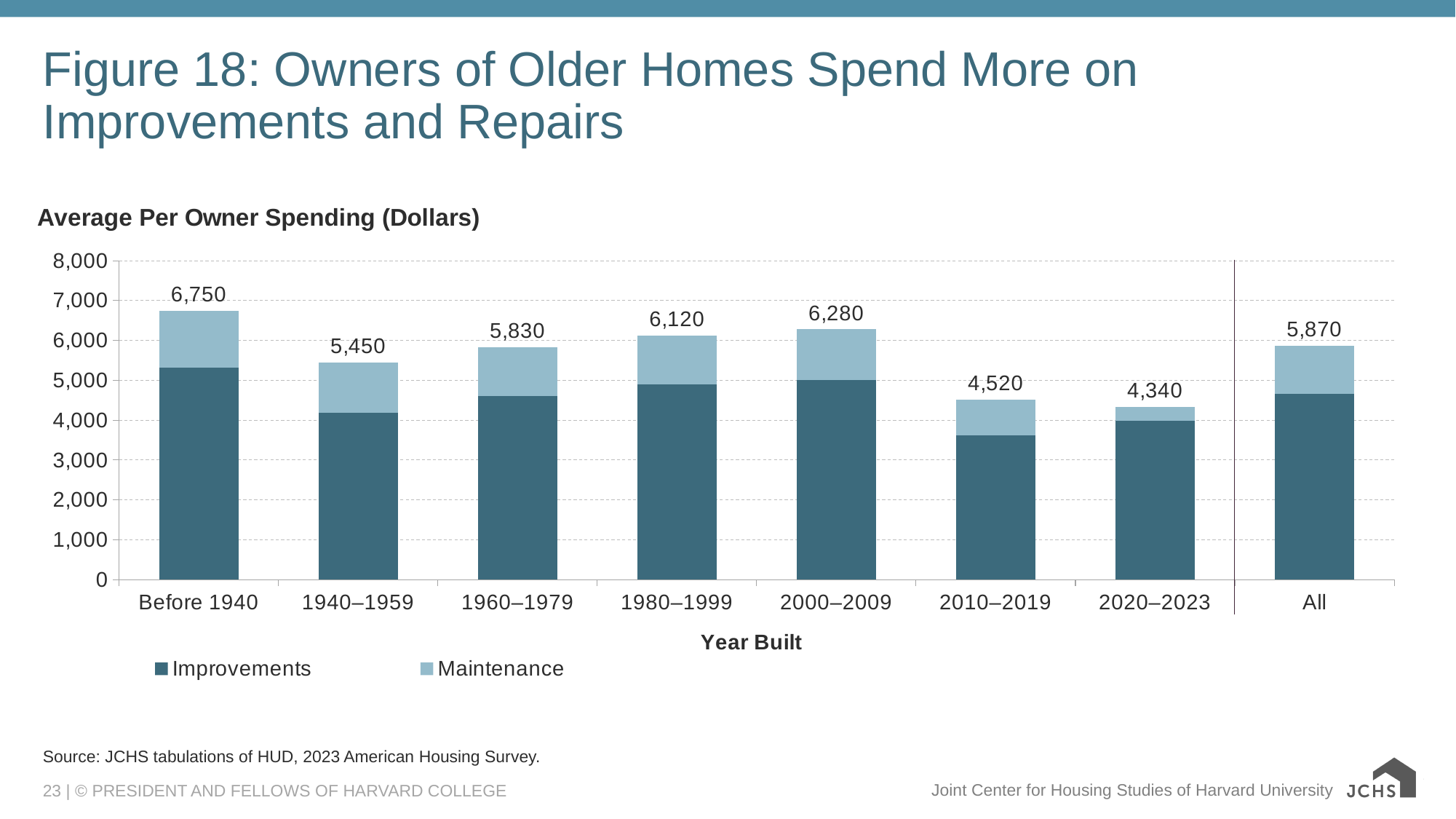
Is the Improvements value for homes built 2010–2019 greater or less than 4,000? less What is the difference in total spending between homes built before 1940 and homes built 2020–2023? 2,410 Which year-built category has the lowest total spending? 2020–2023 What is the total average per owner spending for homes built 2020–2023? 4,340 Is the Improvements value for homes built before 1940 greater or less than 5,000? greater Which year-built category has the highest total spending? Before 1940 What is the total average per owner spending for the 'All' category? 5,870 How many series does the legend list? 2 Which has higher total spending: homes built 1980–1999 or homes built 2000–2009? 2000–2009 What is the total average per owner spending for homes built before 1940? 6,750 How many year-built categories are shown on the x axis, including 'All'? 8 What kind of chart is shown on the slide? Stacked bar chart